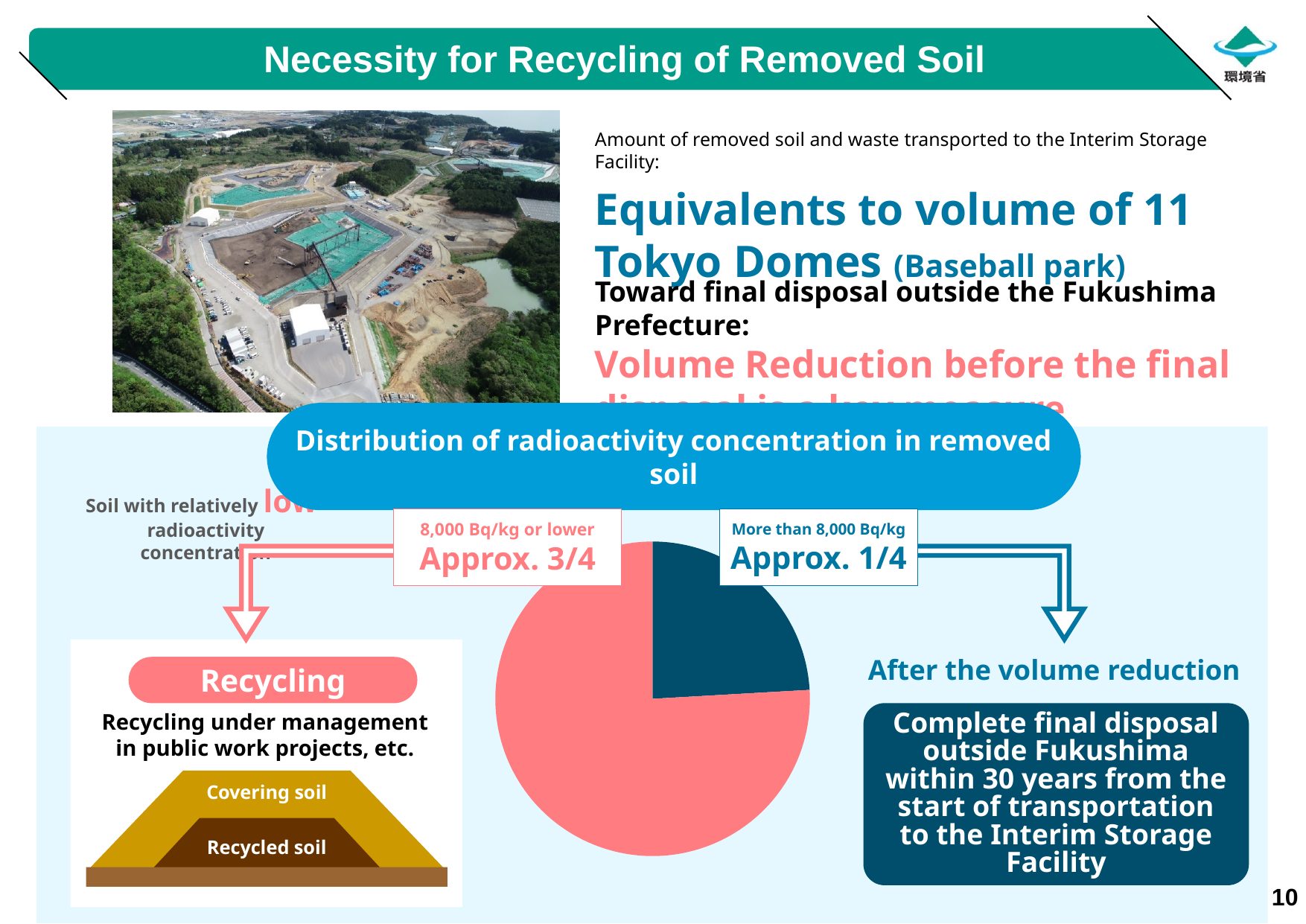
In the pie chart, which is larger: the slice for 8,000 Bq/kg or lower or the slice for more than 8,000 Bq/kg? 8,000 Bq/kg or lower What share of the pie chart is labelled for soil with more than 8,000 Bq/kg? Approx. 1/4 Which slice of the pie chart is the smallest? More than 8,000 Bq/kg Which slice of the pie chart is the largest? 8,000 Bq/kg or lower What share of the pie chart is labelled for soil with 8,000 Bq/kg or lower? Approx. 3/4 What kind of chart is shown under the heading "Distribution of radioactivity concentration in removed soil"? pie chart How many slices does the pie chart have? 2 What colour is the pie slice for soil with more than 8,000 Bq/kg? dark blue What is the title of the pie chart? Distribution of radioactivity concentration in removed soil